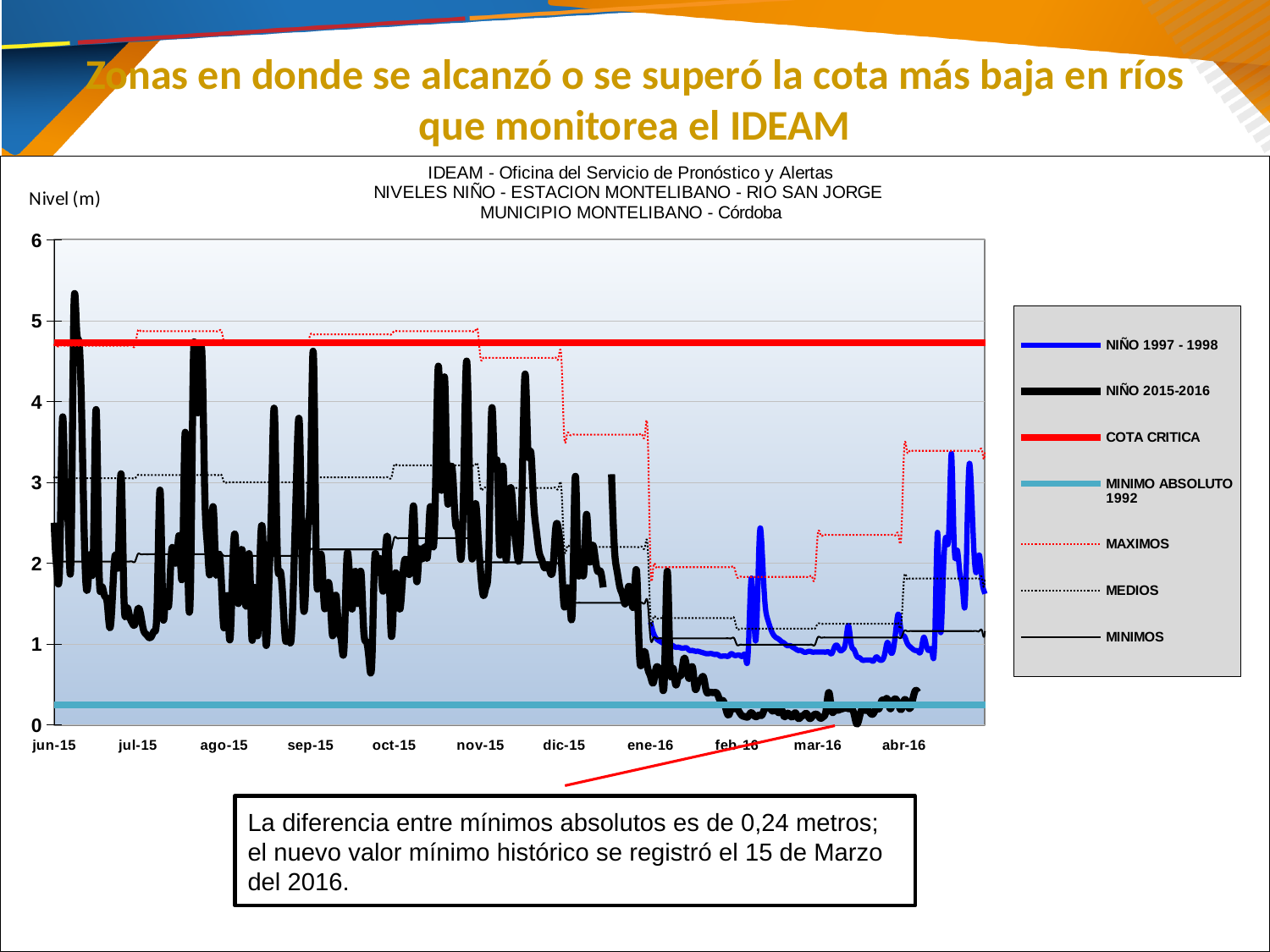
Is the COTA CRITICA level greater or less than 5? less What kind of chart is shown on the slide? line chart Which is higher on the chart, the COTA CRITICA line or the MINIMO ABSOLUTO 1992 line? COTA CRITICA How many series does the chart legend list? 7 Does the NIÑO 2015-2016 series generally rise or fall from jun-15 to mar-16? fall What is the label of the chart's y axis? Nivel (m) What colour is the NIÑO 1997 - 1998 series in the chart? blue Is the highest peak of the NIÑO 2015-2016 series (in jun-15) greater or less than 5? greater Is the COTA CRITICA level greater or less than 4? greater How many month labels are shown along the x axis of the chart? 11